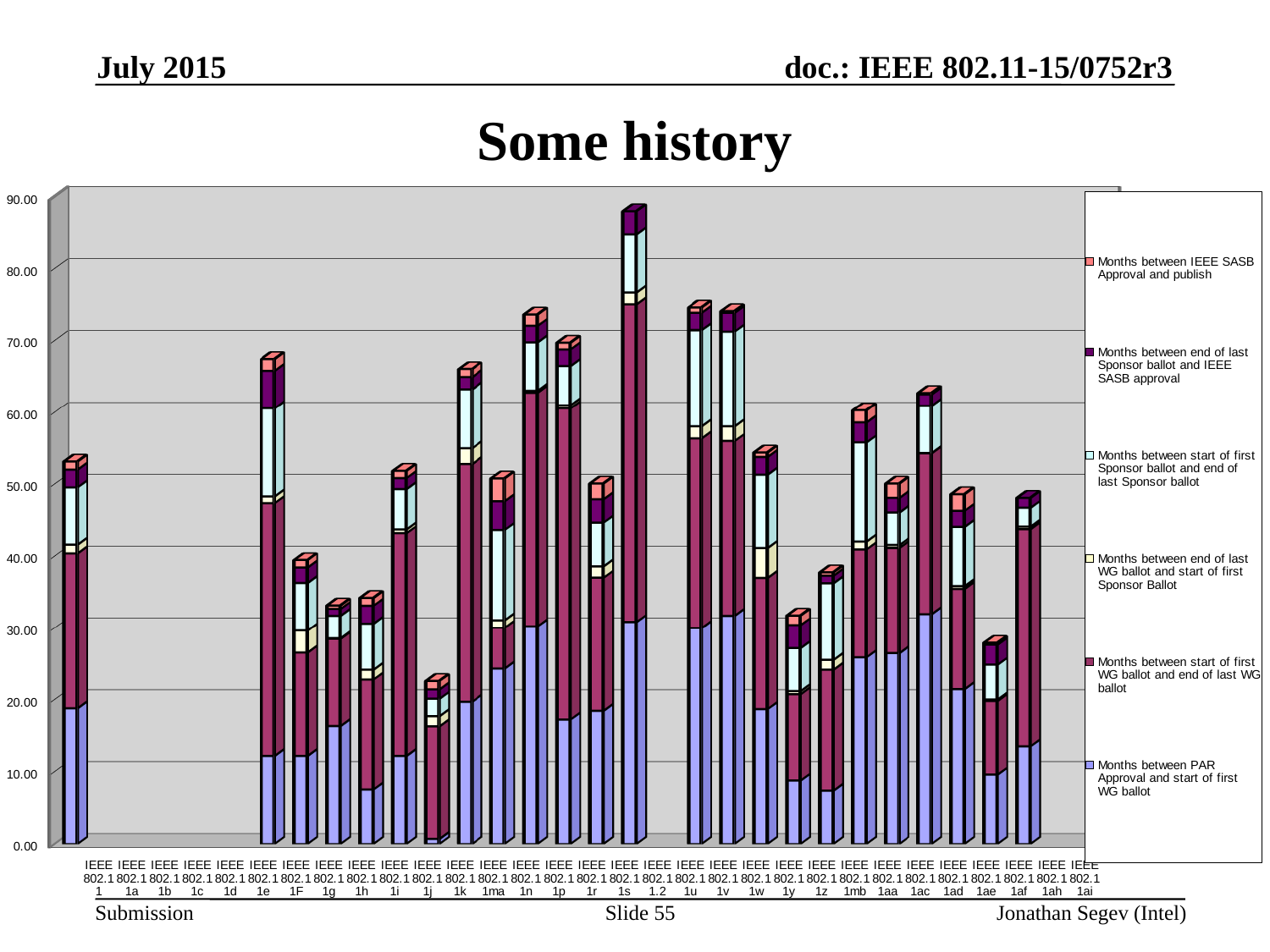
Is the total stacked value for IEEE 802.11y greater or less than 40? less Which has the taller stacked bar, IEEE 802.11j or IEEE 802.11k? IEEE 802.11k How many series does the legend list? 6 Is the total stacked value for IEEE 802.11s greater or less than 80? greater Which has the taller stacked bar, IEEE 802.11n or IEEE 802.11g? IEEE 802.11n Which category has the shortest plotted bar? IEEE 802.11j What kind of chart is shown on the slide? Stacked bar chart Which category has the tallest stacked bar? IEEE 802.11s Is the total stacked value for IEEE 802.11e greater or less than 60? greater What is the title of the slide containing the chart? Some history How many categories are labelled along the x axis? 31